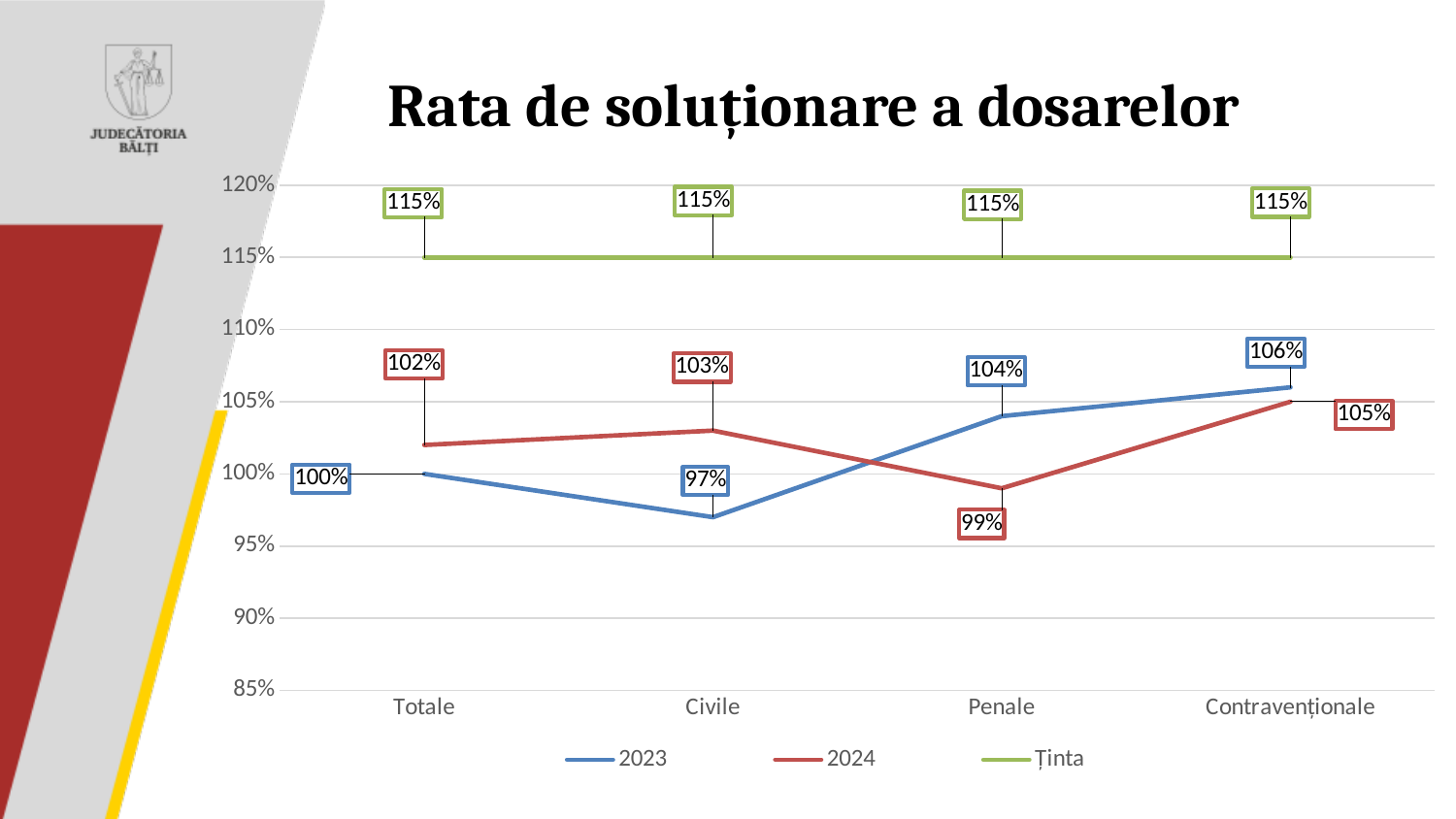
What is the difference between the 2024 and 2023 values for Totale? 2% How many categories are shown on the x axis? 4 How many series does the legend list? 3 Which category has the highest value in the 2023 series? Contravenționale What kind of chart is shown on the slide? line chart What is the value for Contravenționale in the 2023 series? 106% Which category has the lowest value in the 2024 series? Penale What is the Ținta value for Totale? 115% What is the title of the chart? Rata de soluționare a dosarelor What is the value for Penale in the 2024 series? 99% Which is larger for Penale, the 2023 value or the 2024 value? 2023 What is the value for Civile in the 2023 series? 97%